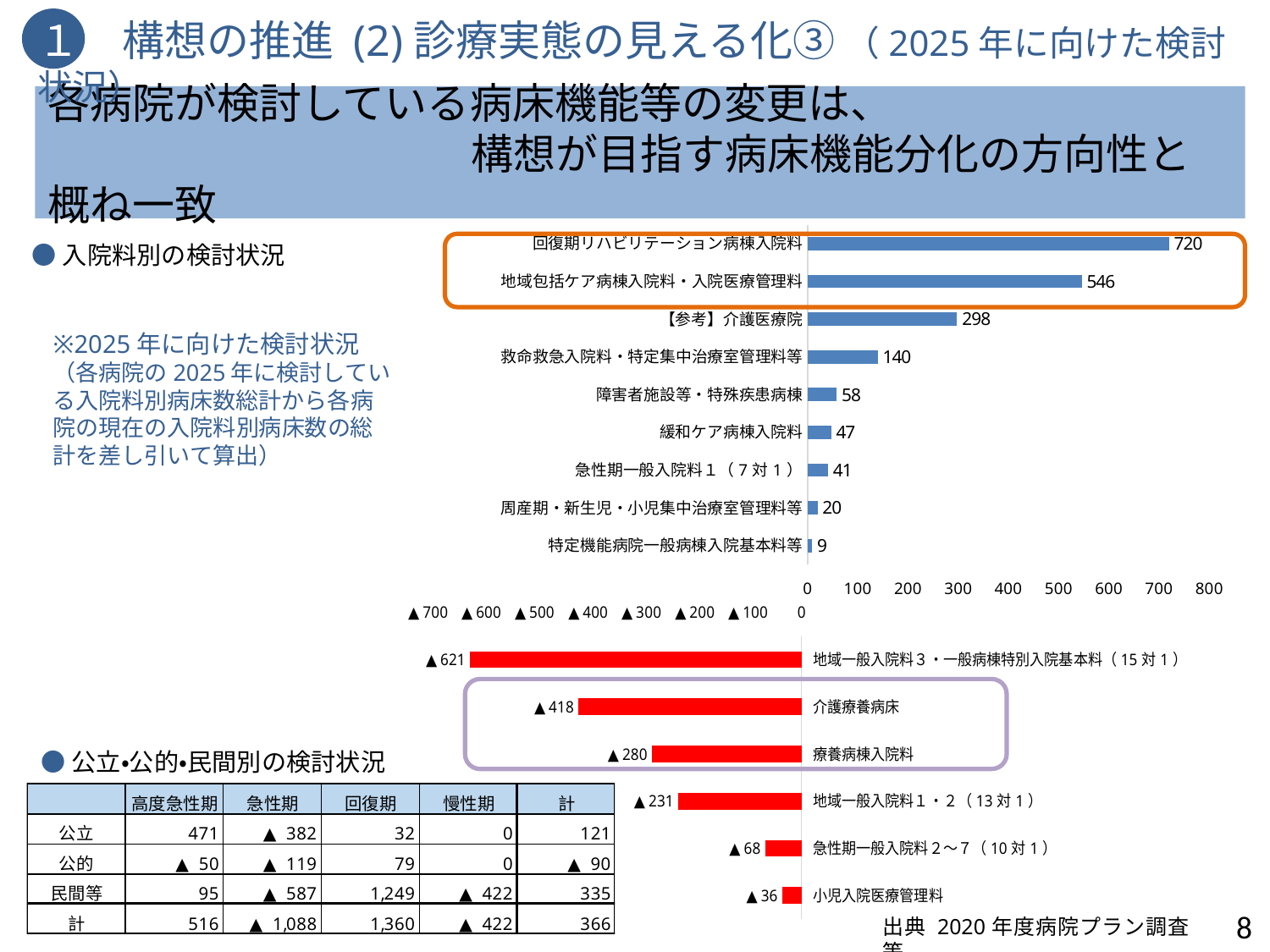
In the lower red bar chart, which category has the largest decrease? 地域一般入院料3・一般病棟特別入院基本料（15対1） In the upper blue bar chart, what is the value for 地域包括ケア病棟入院料・入院医療管理料? 546 What type of chart is the upper blue chart? Bar chart In the lower red bar chart, what is the value for 療養病棟入院料? ▲280 In the lower red bar chart, what is the value for 小児入院医療管理料? ▲36 In the upper blue bar chart, what is the difference between the values for 回復期リハビリテーション病棟入院料 and 【参考】介護医療院? 422 In the upper blue bar chart, which category has the lowest value? 特定機能病院一般病棟入院基本料等 In the lower red bar chart, how many categories are plotted? 6 In the upper blue bar chart, which is larger: 緩和ケア病棟入院料 or 急性期一般入院料1（7対1）? 緩和ケア病棟入院料 In the upper blue bar chart, what is the value for 回復期リハビリテーション病棟入院料? 720 In the lower red bar chart, what is the value for 介護療養病床? ▲418 In the upper blue bar chart, how many categories are plotted? 9